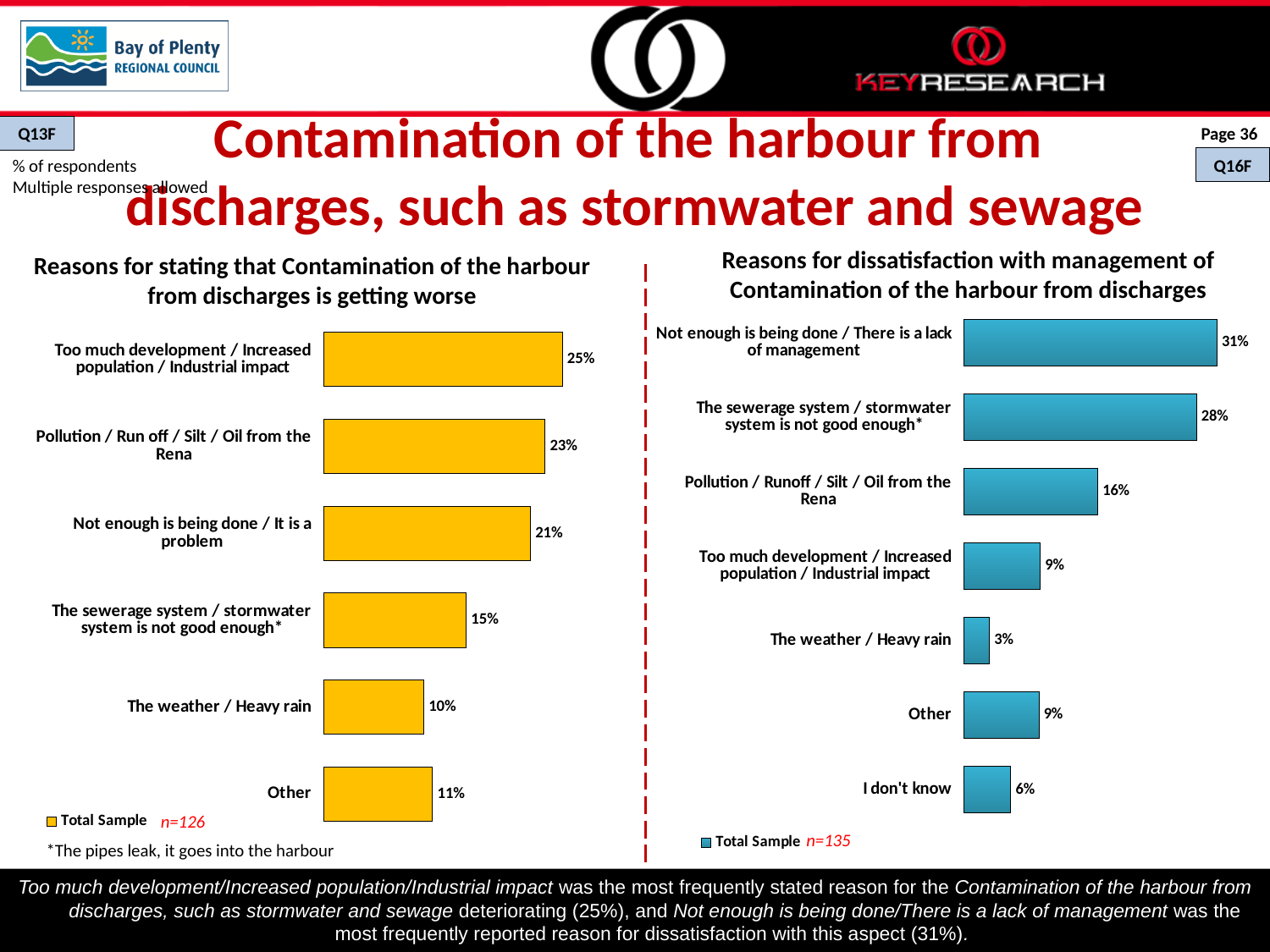
In the left chart (Reasons for stating that Contamination of the harbour from discharges is getting worse), which reason has the lowest percentage? The weather / Heavy rain How many reasons (categories) are plotted in the left chart (Reasons for stating that Contamination of the harbour from discharges is getting worse)? 6 In the right chart (Reasons for dissatisfaction with management of Contamination of the harbour from discharges), which reason has the highest percentage? Not enough is being done / There is a lack of management What type of chart is the left chart (Reasons for stating that Contamination of the harbour from discharges is getting worse)? Bar chart In the right chart (Reasons for dissatisfaction with management of Contamination of the harbour from discharges), what percentage is shown for 'The sewerage system / stormwater system is not good enough*'? 28% In the right chart (Reasons for dissatisfaction with management of Contamination of the harbour from discharges), which reason has the lowest percentage? The weather / Heavy rain How many reasons (categories) are plotted in the right chart (Reasons for dissatisfaction with management of Contamination of the harbour from discharges)? 7 In the left chart (Reasons for stating that Contamination of the harbour from discharges is getting worse), what percentage is shown for 'Too much development / Increased population / Industrial impact'? 25% In the right chart (Reasons for dissatisfaction with management of Contamination of the harbour from discharges), what percentage is shown for 'I don't know'? 6% In the left chart (Reasons for stating that Contamination of the harbour from discharges is getting worse), what is the difference in percentage points between 'Too much development / Increased population / Industrial impact' and 'The sewerage system / stormwater system is not good enough*'? 10 percentage points In the left chart (Reasons for stating that Contamination of the harbour from discharges is getting worse), what percentage is shown for 'The weather / Heavy rain'? 10% In the right chart (Reasons for dissatisfaction with management of Contamination of the harbour from discharges), which is larger: 'Pollution / Runoff / Silt / Oil from the Rena' or 'Too much development / Increased population / Industrial impact'? Pollution / Runoff / Silt / Oil from the Rena